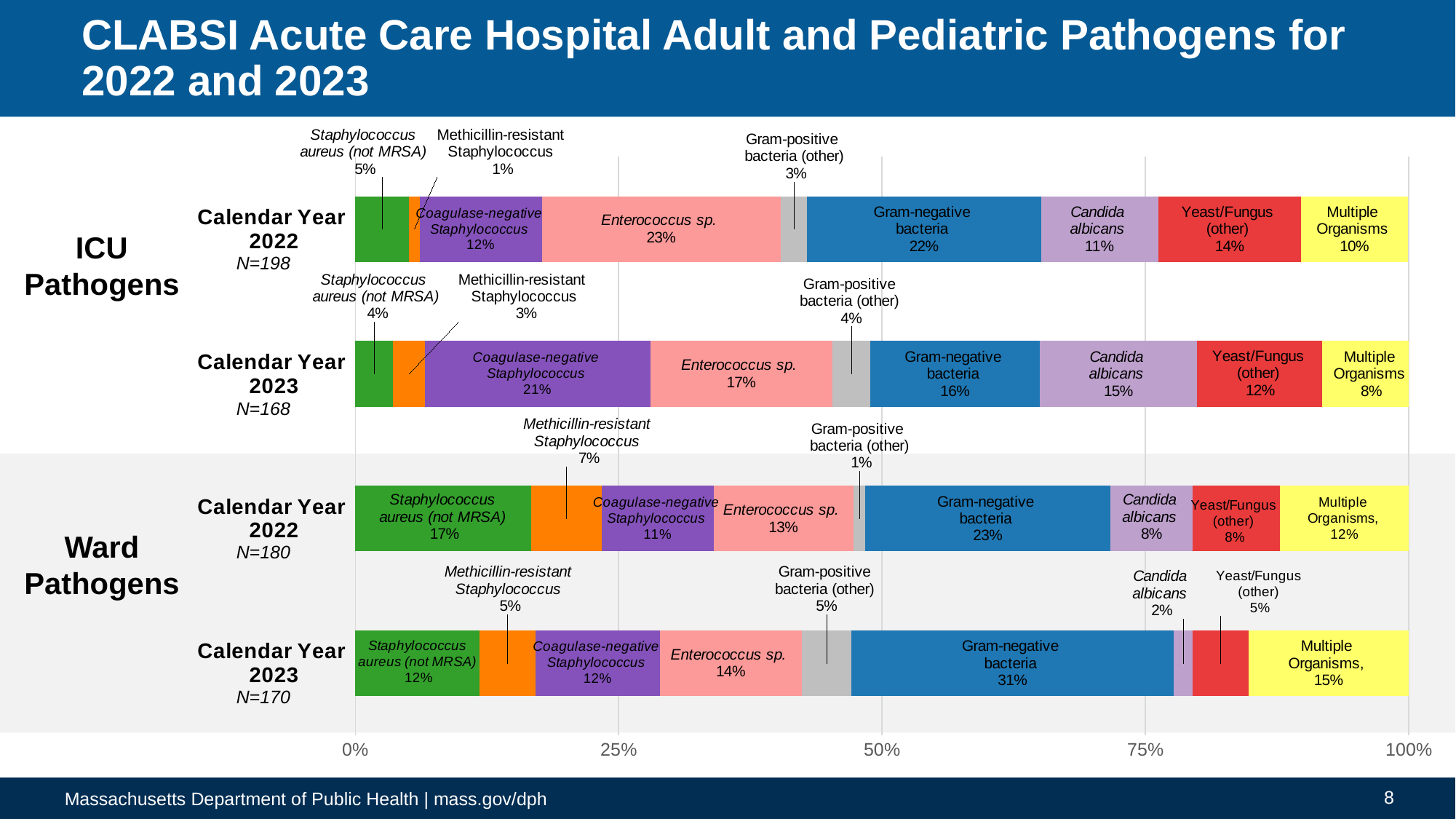
Which pathogen category had the largest share of ICU pathogens in Calendar Year 2022? Enterococcus sp. What kind of chart is shown on the slide? Stacked bar chart What percentage of Ward pathogens in Calendar Year 2022 were Staphylococcus aureus (not MRSA)? 17% What is the N value for ICU pathogens in Calendar Year 2022? N=198 Which pathogen category had the smallest share of Ward pathogens in Calendar Year 2022? Gram-positive bacteria (other) How many bars (calendar year groups) are shown in the chart? 4 What percentage of ICU pathogens in Calendar Year 2022 were Enterococcus sp.? 23% Which was larger for ICU pathogens in Calendar Year 2023: Candida albicans or Yeast/Fungus (other)? Candida albicans What is the difference between the Gram-negative bacteria share for Ward pathogens in Calendar Year 2023 and Calendar Year 2022? 8 percentage points What percentage of Ward pathogens in Calendar Year 2023 were Gram-negative bacteria? 31% What colour represents Gram-negative bacteria in the chart? Blue What percentage of ICU pathogens in Calendar Year 2023 were Coagulase-negative Staphylococcus? 21%